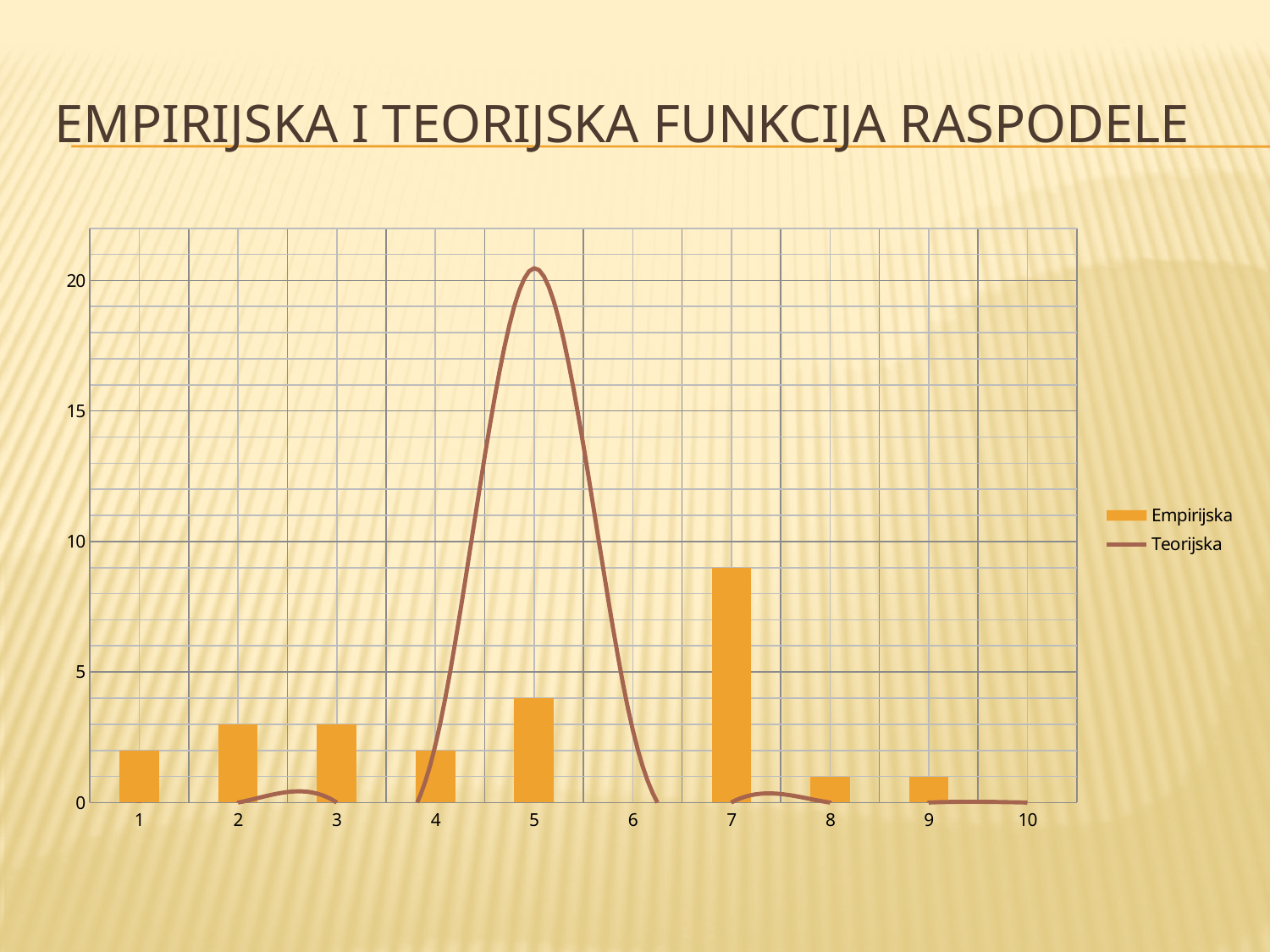
What is the title of the slide? EMPIRIJSKA I TEORIJSKA FUNKCIJA RASPODELE How many categories are shown on the x axis? 10 Which category has the highest Empirijska bar? 7 How many series does the legend list? 2 Is the Empirijska value for category 7 greater or less than 10? less What kind of chart is shown on the slide? bar chart with a line Is the Empirijska value for category 7 greater or less than 5? greater At which category does the Teorijska line reach its peak? 5 Is the peak of the Teorijska line greater or less than 20? greater Which is larger, the Empirijska value for category 7 or for category 5? category 7 Which series is drawn as a line? Teorijska